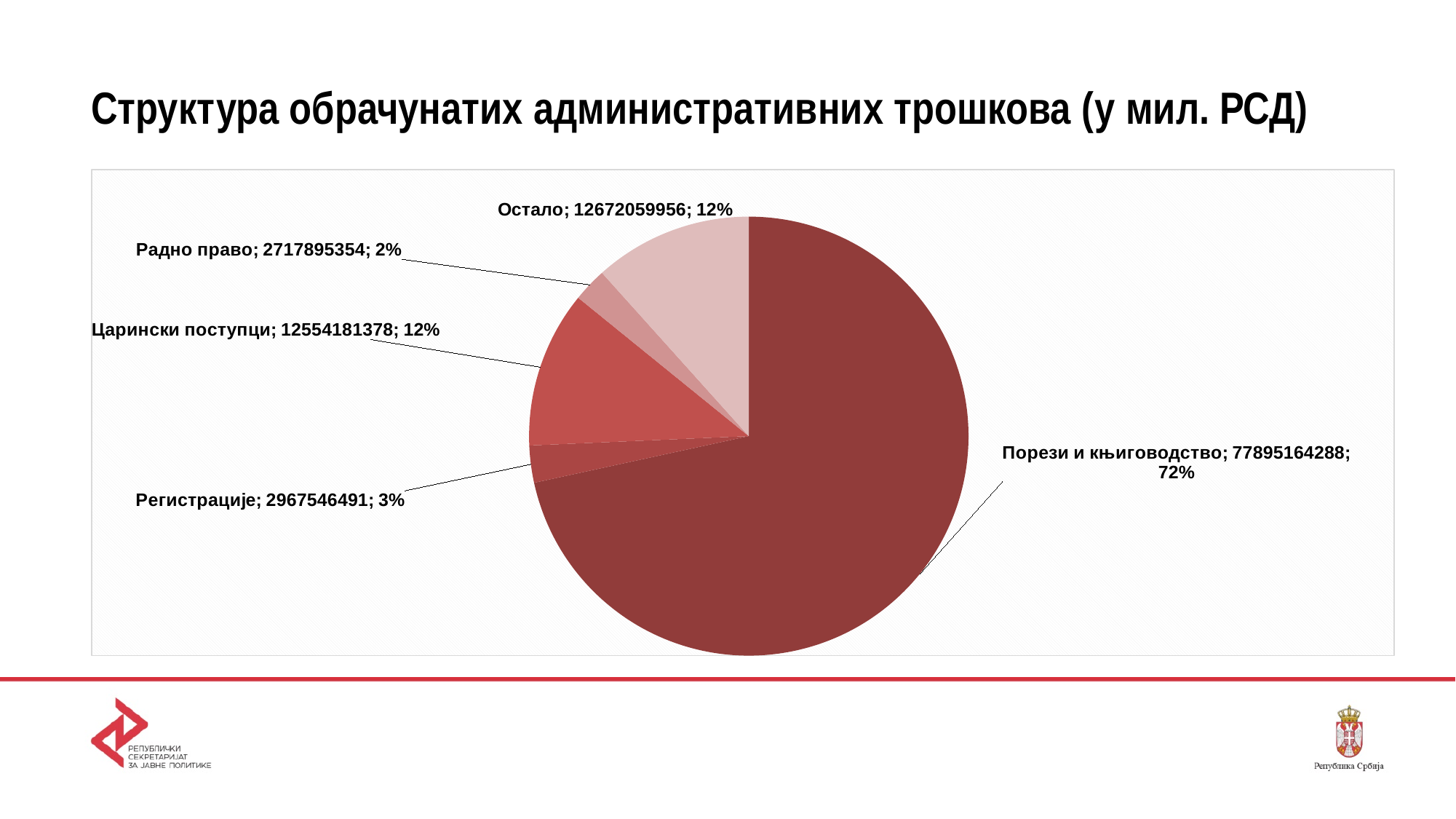
What is the value for Порези и књиговодство? 77895164288 Which is larger, Регистрације or Радно право? Регистрације Which category has the smallest slice? Радно право What kind of chart is shown on the slide? pie chart How many slices does the pie chart have? 5 What is the difference between the values for Порези и књиговодство and Остало? 65223104332 What is the value for Регистрације? 2967546491 What is the value for Царински поступци? 12554181378 What share of the pie does Порези и књиговодство represent? 72% What is the value for Радно право? 2717895354 What share of the pie does Остало represent? 12% Which category has the largest slice? Порези и књиговодство